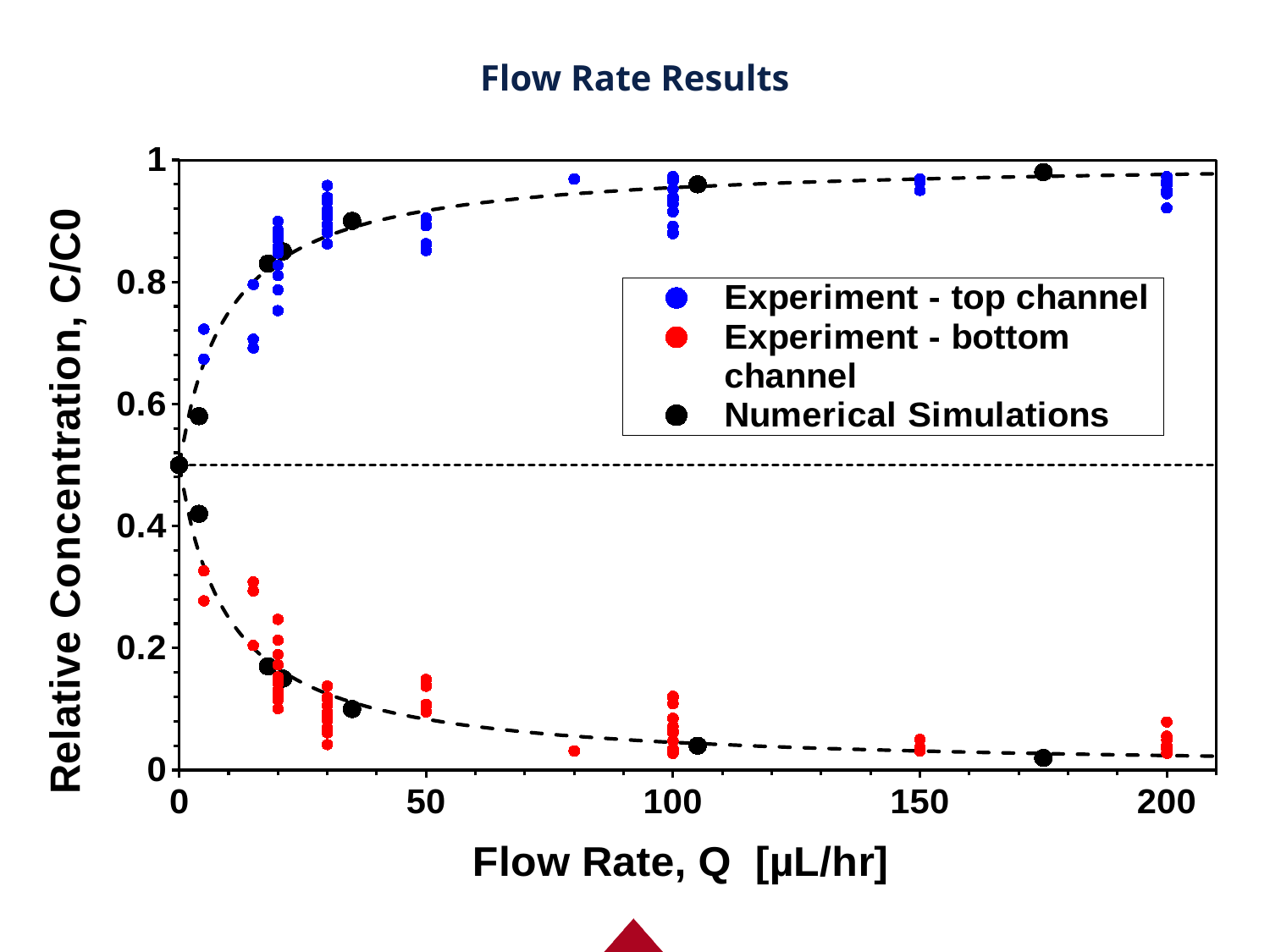
What is the label of the x axis? Flow Rate, Q [µL/hr] Do the Experiment - top channel values rise or fall as flow rate increases? rise What kind of chart is shown on the slide? scatter plot Is the value for Experiment - bottom channel at a flow rate of 200 greater or less than 0.2? less Do the Experiment - bottom channel values rise or fall as flow rate increases? fall Is the Numerical Simulations value at a flow rate of 175 on the upper curve greater or less than 0.8? greater How many series does the legend list? 3 What is the title of the chart? Flow Rate Results At a flow rate of 100, which series has the larger values: Experiment - top channel or Experiment - bottom channel? Experiment - top channel Is the value for Experiment - top channel at a flow rate of 200 greater or less than 0.8? greater